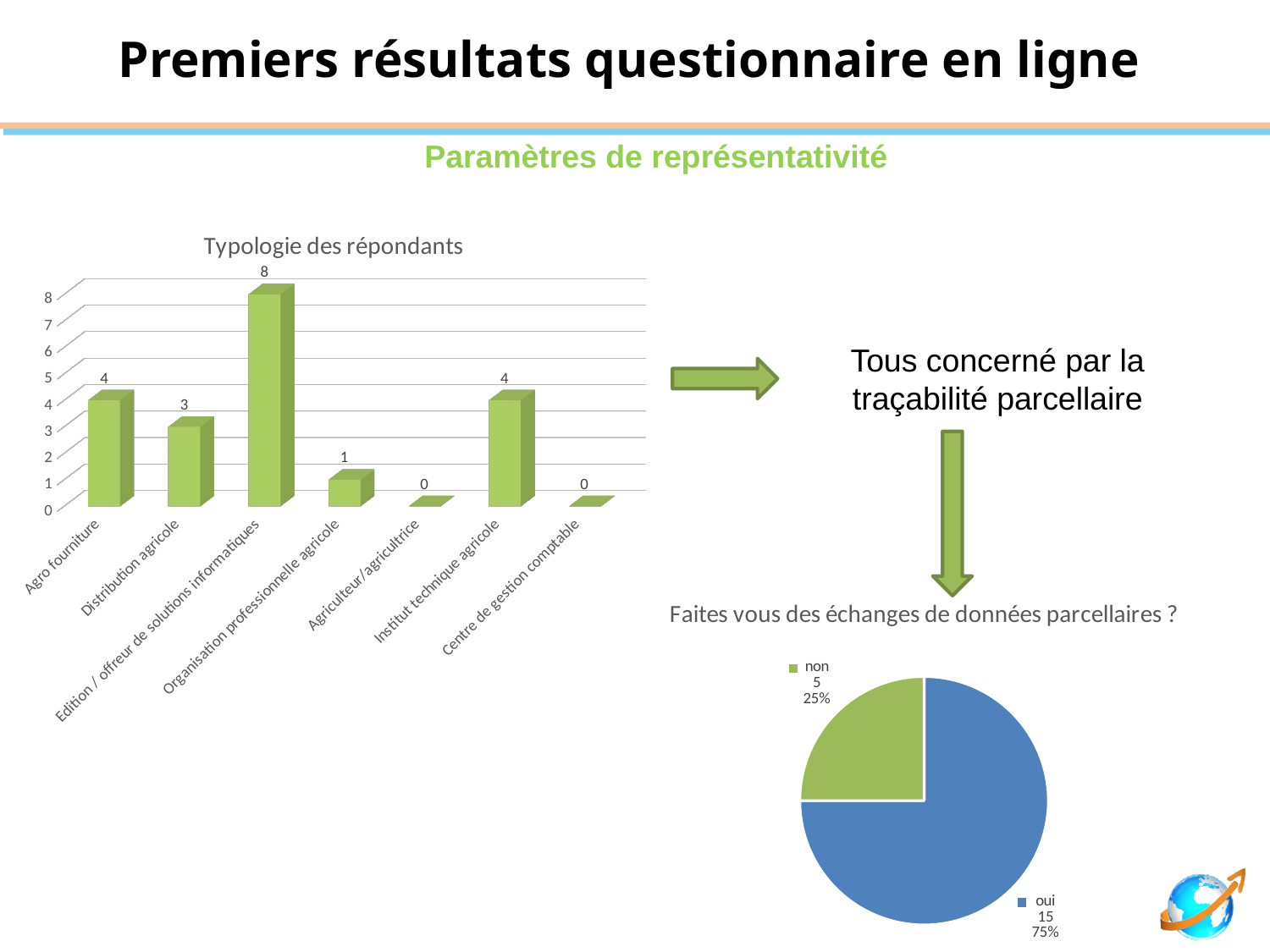
In the 'Typologie des répondants' chart, which category has the highest value? Edition / offreur de solutions informatiques In the pie chart 'Faites vous des échanges de données parcellaires ?', what is the value for 'non'? 5 In the 'Typologie des répondants' chart, what is the value for Edition / offreur de solutions informatiques? 8 In the 'Typologie des répondants' chart, what is the value for Organisation professionnelle agricole? 1 In the 'Typologie des répondants' chart, how many categories have a value of 0? 2 In the 'Typologie des répondants' chart, what is the difference between Edition / offreur de solutions informatiques and Agro fourniture? 4 In the 'Typologie des répondants' chart, which is larger: Distribution agricole or Institut technique agricole? Institut technique agricole What kind of chart is 'Typologie des répondants'? bar chart What kind of chart is 'Faites vous des échanges de données parcellaires ?'? pie chart In the pie chart 'Faites vous des échanges de données parcellaires ?', what share is 'oui'? 75% In the 'Typologie des répondants' chart, what is the value for Distribution agricole? 3 How many categories are shown in the 'Typologie des répondants' chart? 7